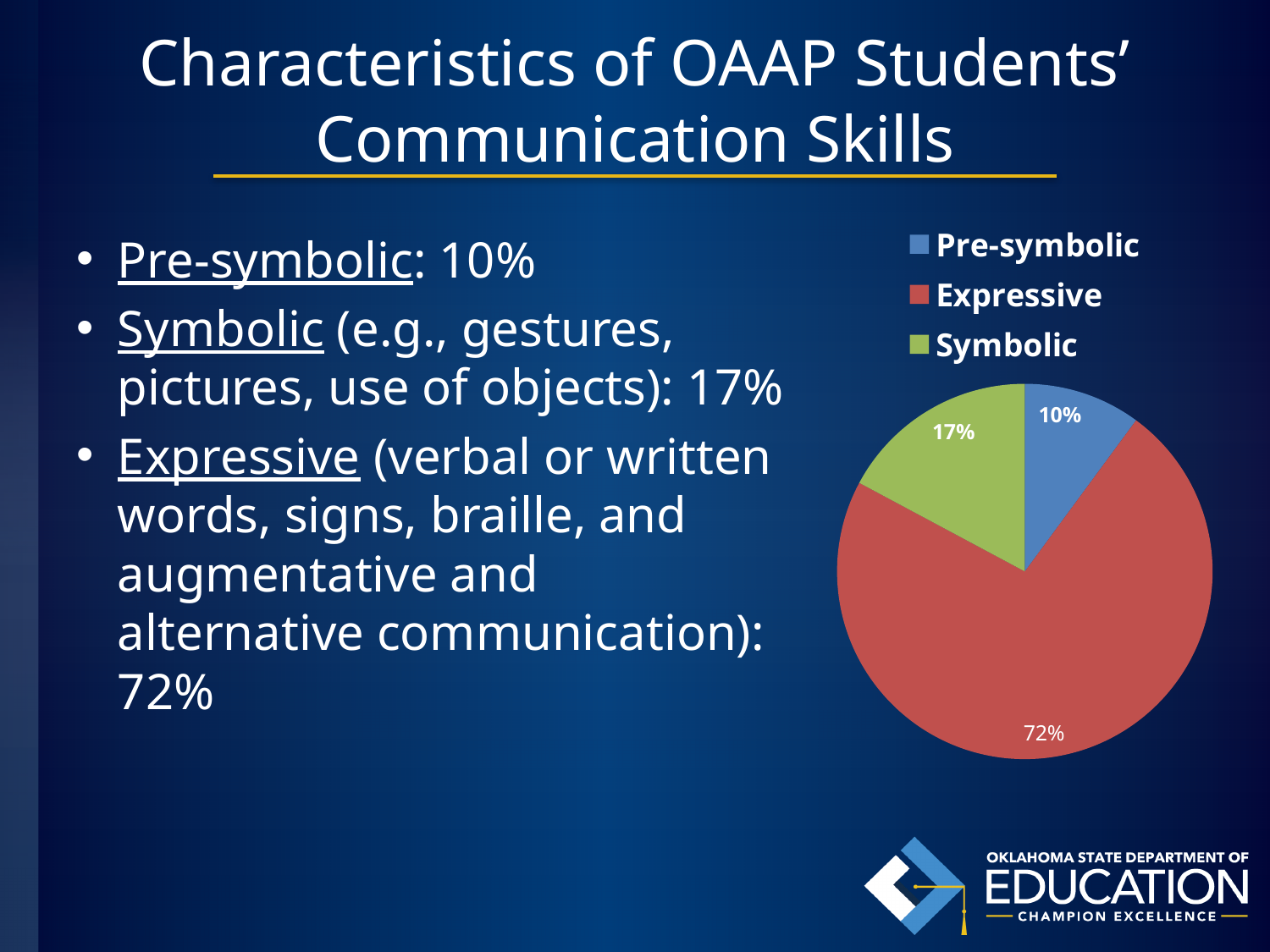
What is the difference between the Symbolic and Pre-symbolic shares? 7% Which category has the smallest slice of the pie? Pre-symbolic What share of the pie does Pre-symbolic represent? 10% Which is larger, the Symbolic slice or the Pre-symbolic slice? Symbolic Which category is listed first in the legend? Pre-symbolic What is the difference between the Expressive and Symbolic shares? 55% What share of the pie does Expressive represent? 72% What share of the pie does Symbolic represent? 17% What kind of chart is shown on the slide? pie chart What colour is the Expressive slice in the pie chart? red Which category has the largest slice of the pie? Expressive How many categories does the pie chart show? 3